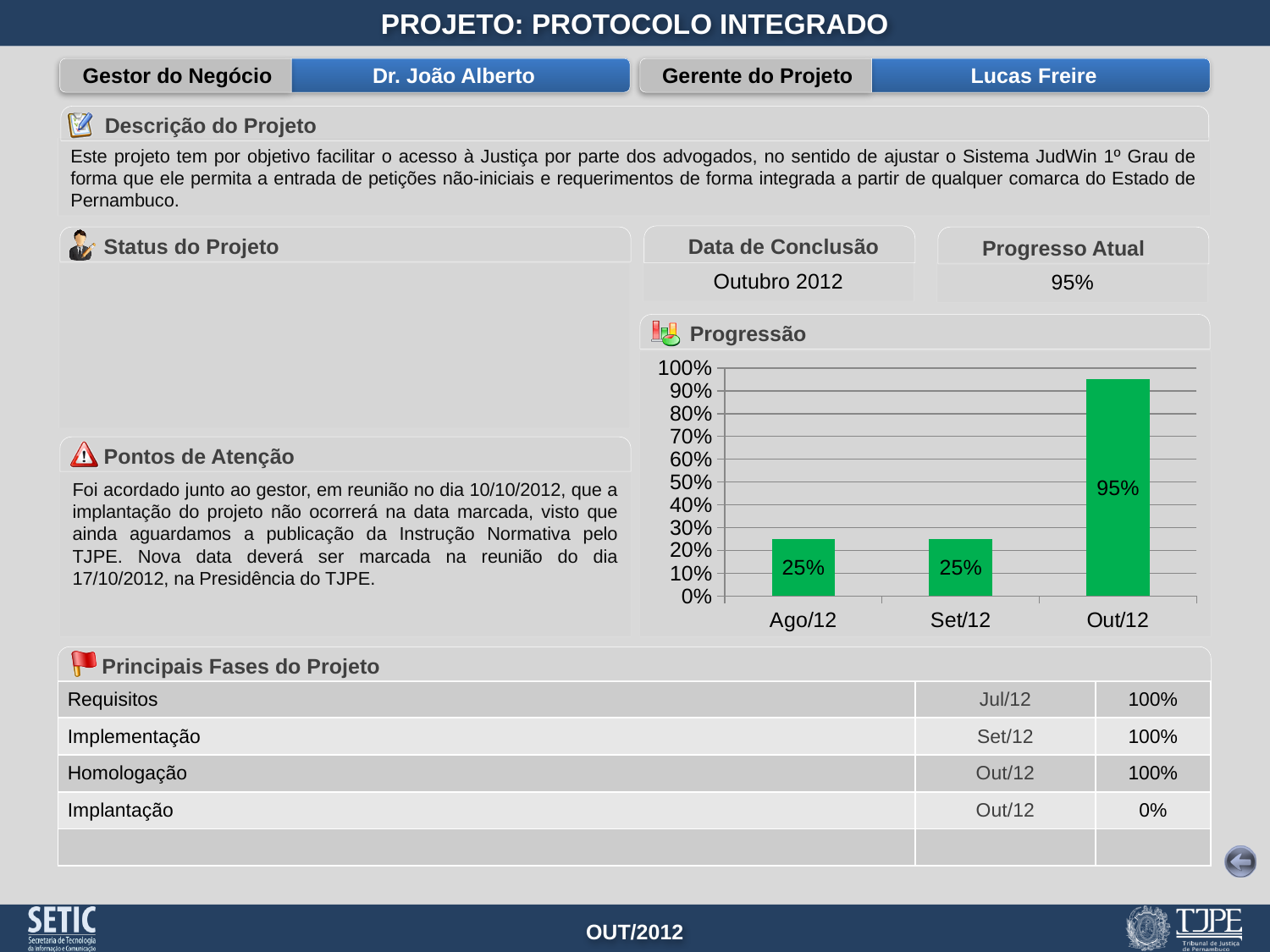
Is the value for Ago/12 in the Progressão chart greater or less than 30%? less How many months are shown on the x axis of the Progressão chart? 3 What is the value for Out/12 in the Progressão chart? 95% Which month has the highest value in the Progressão chart? Out/12 What is the value for Ago/12 in the Progressão chart? 25% What is the difference between the values for Out/12 and Set/12 in the Progressão chart? 70% What kind of chart is the Progressão chart? bar chart Is the value for Out/12 in the Progressão chart greater or less than 90%? greater Do the values in the Progressão chart rise or fall from Ago/12 to Out/12? rise What is the value for Set/12 in the Progressão chart? 25% Which is larger in the Progressão chart, the value for Out/12 or the value for Ago/12? Out/12 What is the title of the chart on the slide? Progressão